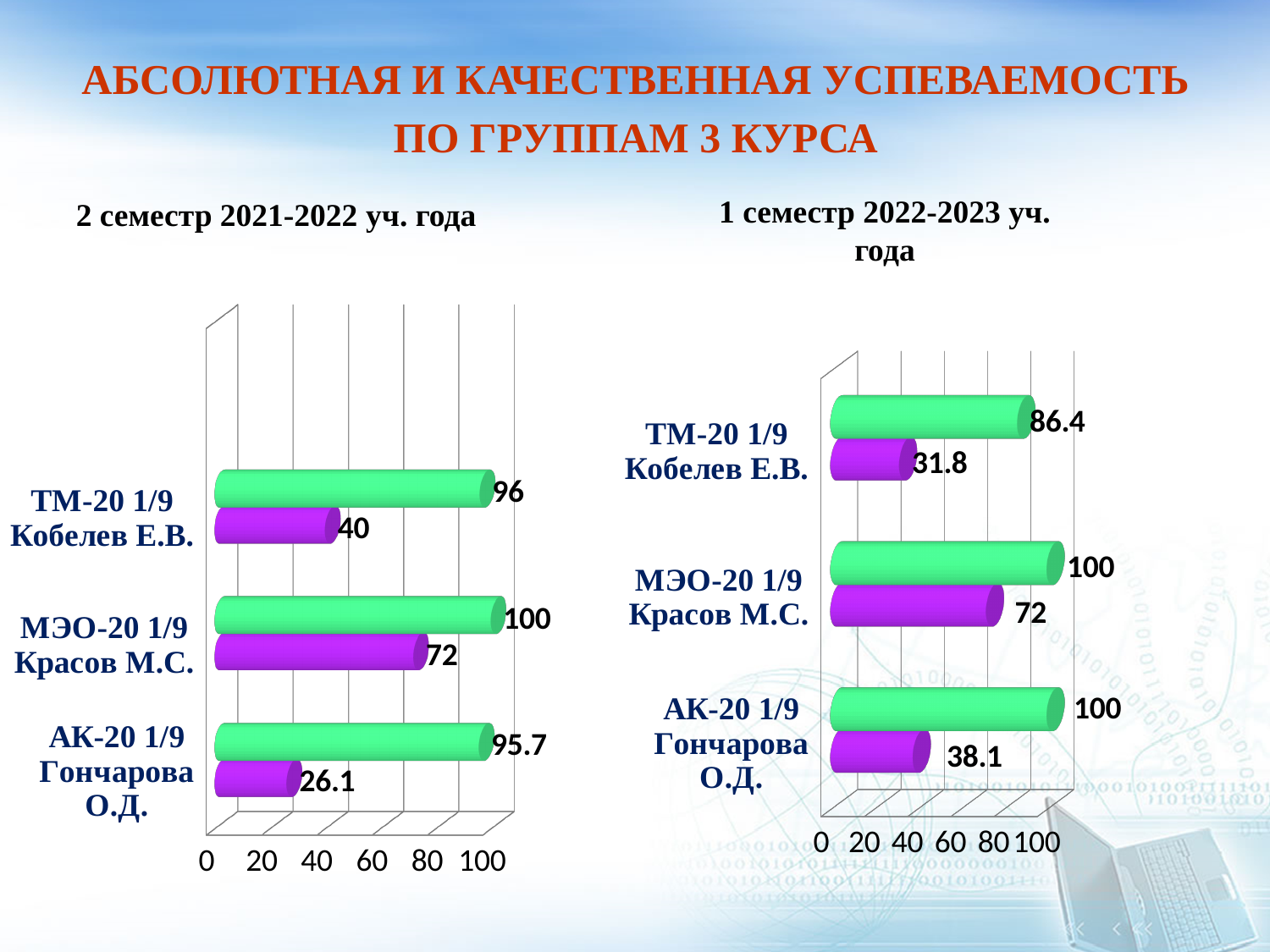
How many groups are shown in the chart for 1 семестр 2022-2023 уч. года? 3 In the chart for 1 семестр 2022-2023 уч. года, what is the value of the green bar for АК-20 1/9 Гончарова О.Д.? 100 In the chart for 1 семестр 2022-2023 уч. года, which group has the highest purple bar value? МЭО-20 1/9 Красов М.С. In the chart for 2 семестр 2021-2022 уч. года, which group has the lowest purple bar value? АК-20 1/9 Гончарова О.Д. In the chart for 2 семестр 2021-2022 уч. года, what is the value of the purple bar for АК-20 1/9 Гончарова О.Д.? 26.1 In the chart for 1 семестр 2022-2023 уч. года, what is the difference between the green and purple bar values for ТМ-20 1/9 Кобелев Е.В.? 54.6 In the chart for 2 семестр 2021-2022 уч. года, is the purple bar value for ТМ-20 1/9 Кобелев Е.В. greater or less than 60? less In the chart for 2 семестр 2021-2022 уч. года, what is the difference between the green and purple bar values for МЭО-20 1/9 Красов М.С.? 28 In the chart for 2 семестр 2021-2022 уч. года, what is the value of the green bar for ТМ-20 1/9 Кобелев Е.В.? 96 In the chart for 1 семестр 2022-2023 уч. года, what is the value of the purple bar for ТМ-20 1/9 Кобелев Е.В.? 31.8 Is the purple bar value for ТМ-20 1/9 Кобелев Е.В. larger in the chart for 2 семестр 2021-2022 уч. года or in the chart for 1 семестр 2022-2023 уч. года? 2 семестр 2021-2022 уч. года What type of chart is used for 2 семестр 2021-2022 уч. года? Bar chart